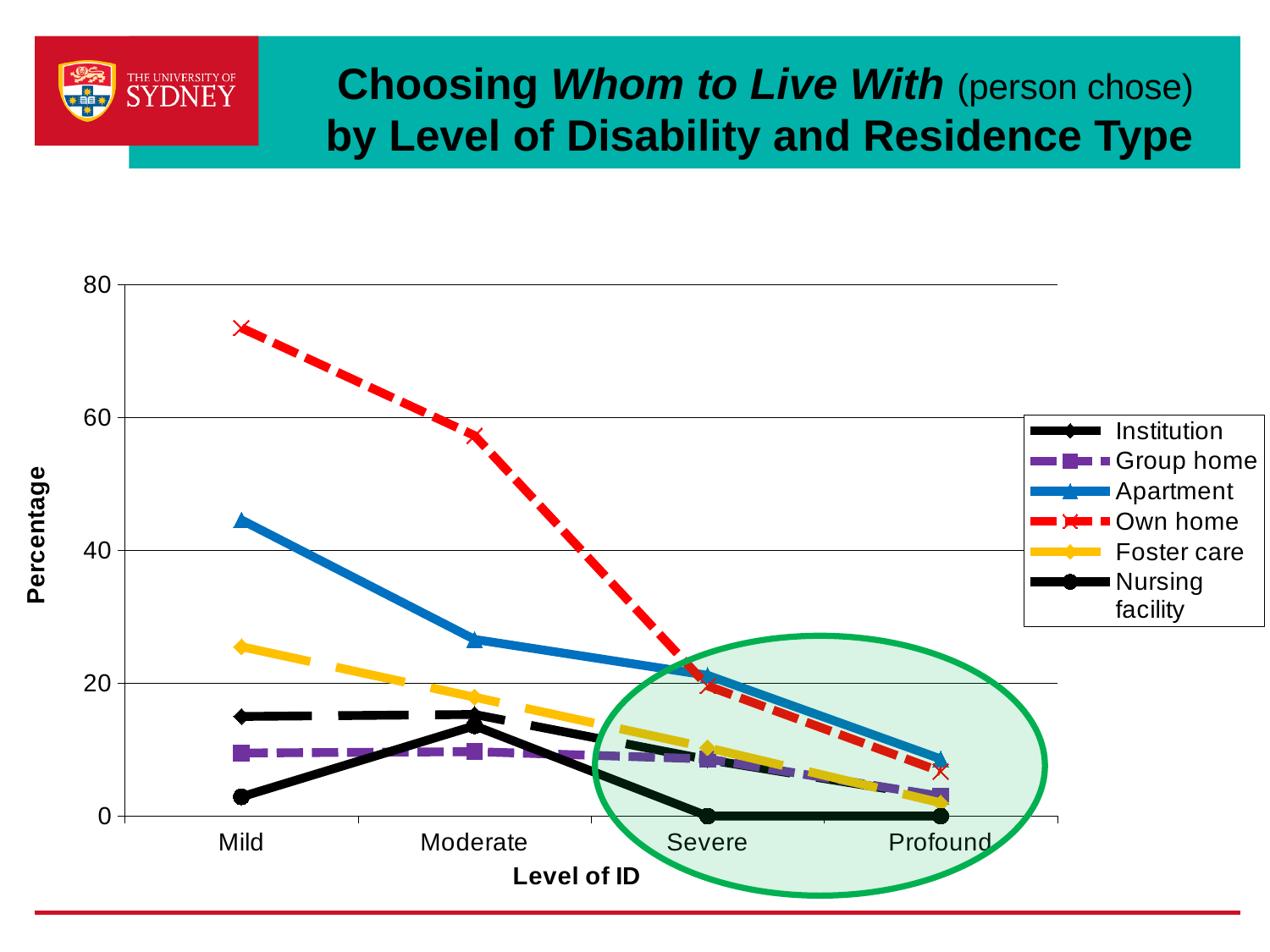
Does the Own home line rise or fall from Mild to Profound? fall What kind of chart is shown on the slide? line chart Is the value for Apartment at the Mild level greater or less than 40? greater Which residence type has the lowest percentage at the Mild level? Nursing facility Is the value for Own home at the Moderate level greater or less than 40? greater Is the value for Own home at the Mild level greater or less than 60? greater How many series does the legend list? 6 How many levels of ID are shown on the x axis? 4 Which residence type has the highest percentage at the Mild level? Own home What is the value for Nursing facility at the Severe level? 0 What is the title of the x axis? Level of ID At the Mild level, which is larger: Apartment or Foster care? Apartment